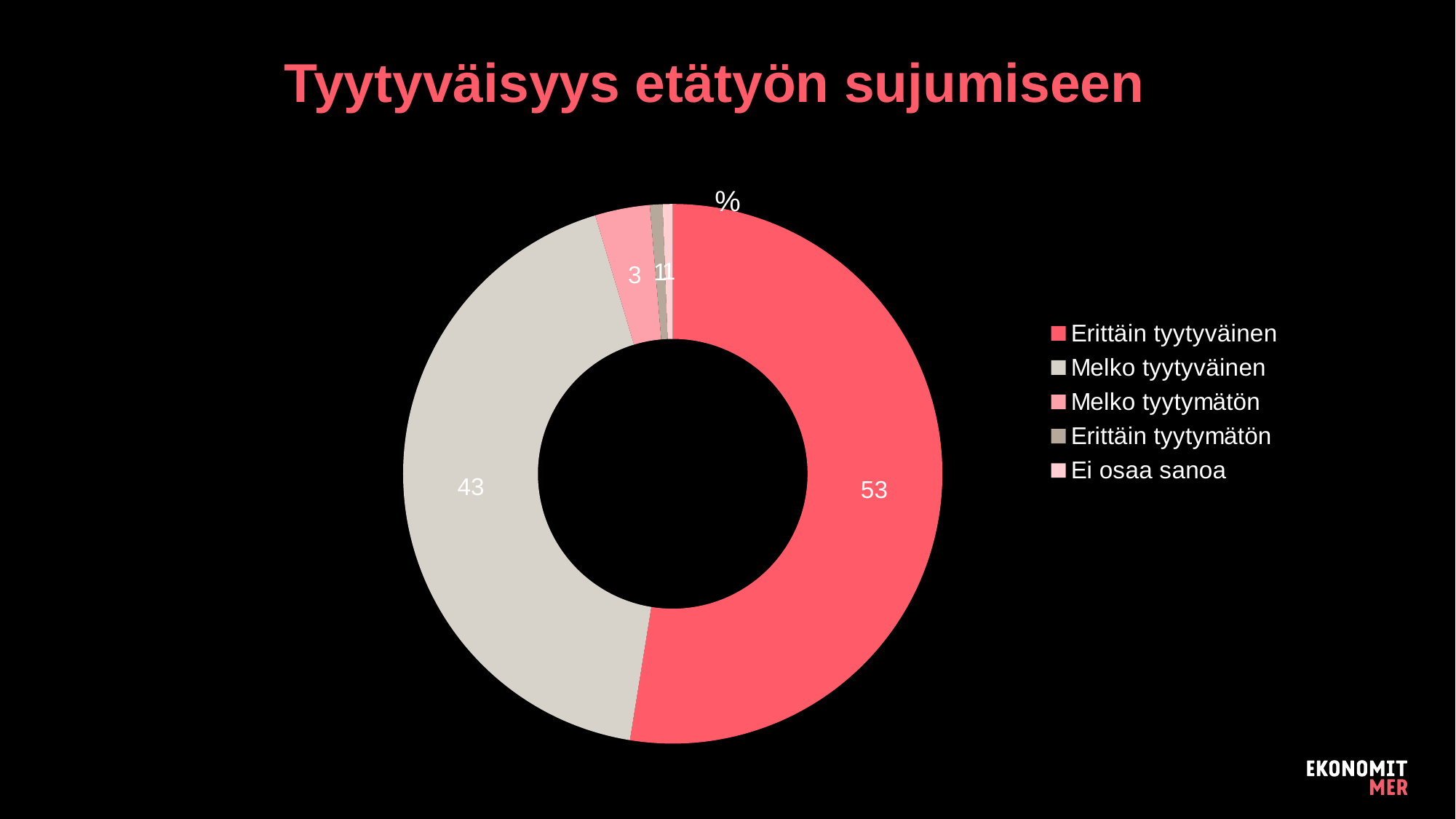
How many categories does the legend list? 5 Is the share for 'Erittäin tyytyväinen' greater or less than 50? greater What colour is the 'Erittäin tyytyväinen' segment? Red What is the title of the chart? Tyytyväisyys etätyön sujumiseen What percentage of respondents are 'Melko tyytyväinen'? 43 Which is larger, the share for 'Melko tyytyväinen' or the share for 'Melko tyytymätön'? Melko tyytyväinen Which category has the largest share of the chart? Erittäin tyytyväinen What is the difference in percentage points between 'Erittäin tyytyväinen' and 'Melko tyytyväinen'? 10 What percentage of respondents are 'Erittäin tyytyväinen'? 53 What is the combined percentage of 'Erittäin tyytyväinen' and 'Melko tyytyväinen'? 96 What percentage of respondents are 'Melko tyytymätön'? 3 What kind of chart is shown on the slide? Doughnut (pie) chart